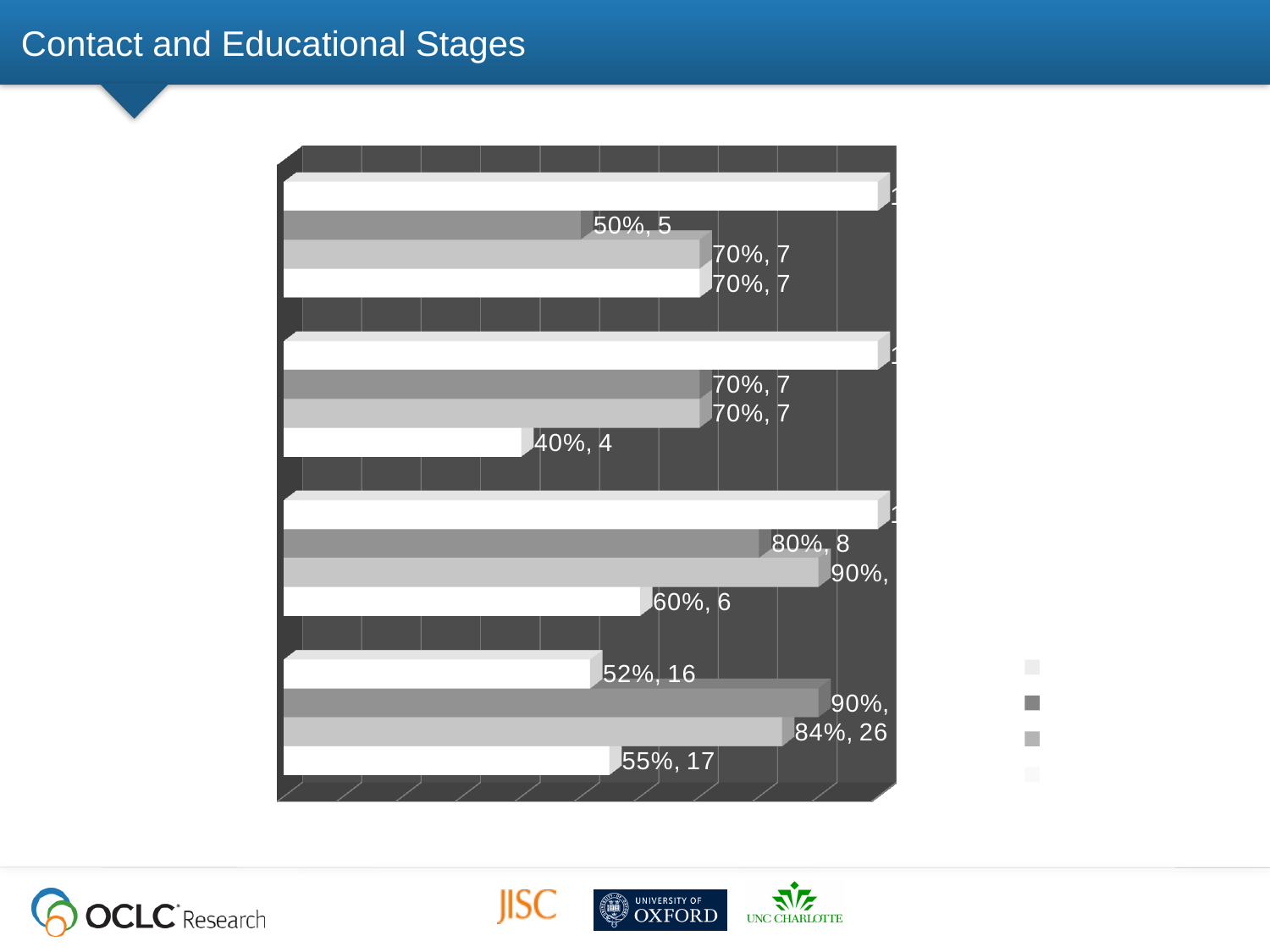
What is the data label on the lowest bar of the bottom group? 55%, 17 What is the data label on the third bar from the top in the bottom group? 84%, 26 In the third group from the top, what is the data label on the lowest bar? 60%, 6 In the bottom group, is the percentage on the third bar from the top larger or smaller than the percentage on the top bar? Larger What is the data label on the lowest bar of the second group from the top? 40%, 4 What is the data label on the top bar of the bottom group? 52%, 16 How many groups of bars does the chart contain? 4 What is the data label on the second bar from the top in the topmost group? 50%, 5 How many series does the legend list? 4 In the bottom group, which bar has the smallest percentage? The top bar (52%, 16) What kind of chart is shown on the slide? Bar chart In the bottom group, what is the difference in percentage points between the third bar from the top (84%) and the top bar (52%)? 32 percentage points